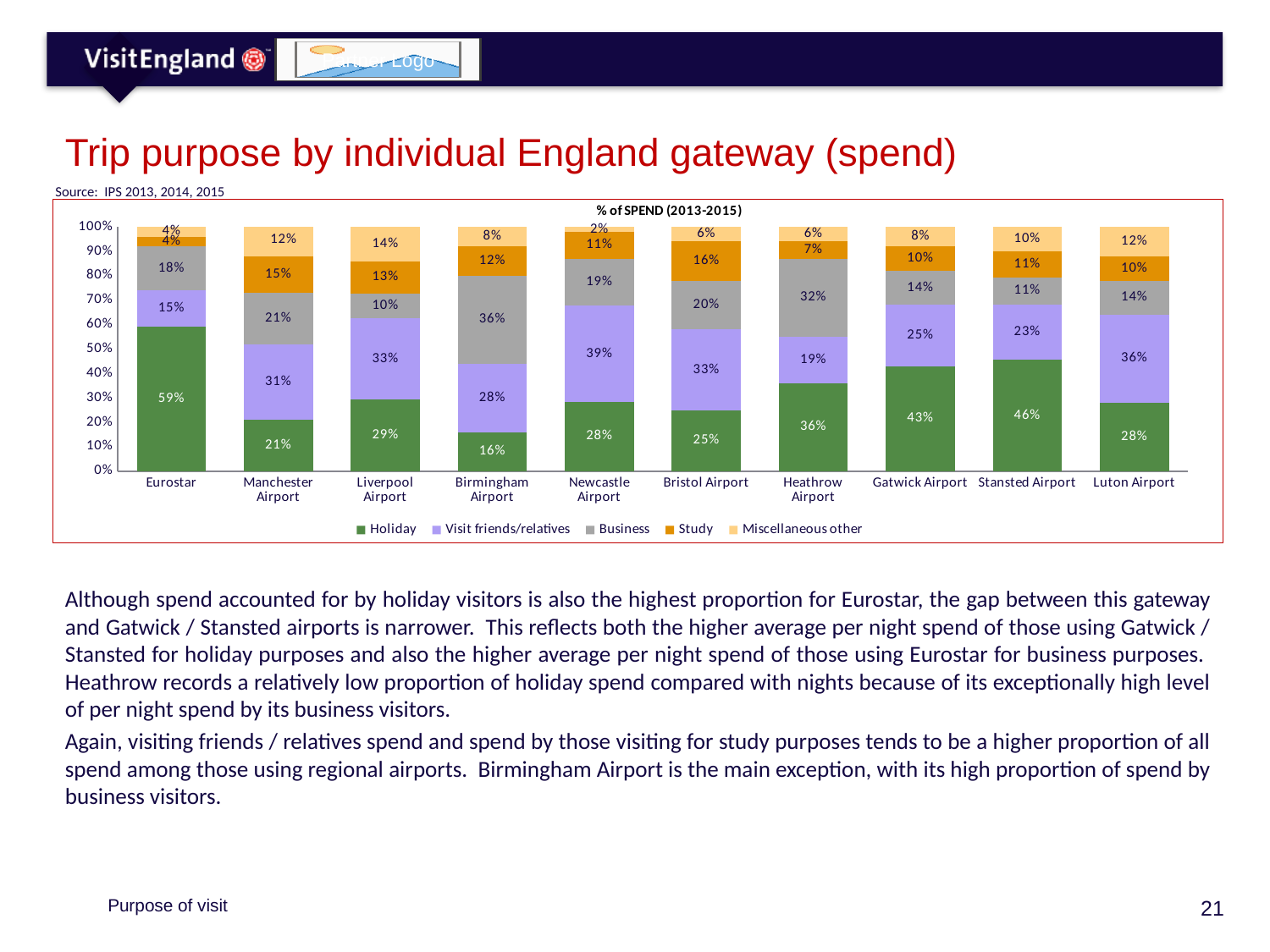
What is the Study share of spend for Bristol Airport? 16% What is the title of the chart? % of SPEND (2013-2015) What is the Business share of spend for Birmingham Airport? 36% How many series does the legend list? 5 Which has a larger Business share of spend, Heathrow Airport or Manchester Airport? Heathrow Airport What is the difference between the Holiday share of spend at Stansted Airport and at Gatwick Airport? 3% Which gateway has the highest Holiday share of spend? Eurostar What percentage of spend at Eurostar is accounted for by Holiday visitors? 59% How many gateways are shown on the x axis of the chart? 10 What is the Visit friends/relatives share of spend for Newcastle Airport? 39% Which gateway has the lowest Holiday share of spend? Birmingham Airport What type of chart is shown on the slide? Stacked bar chart